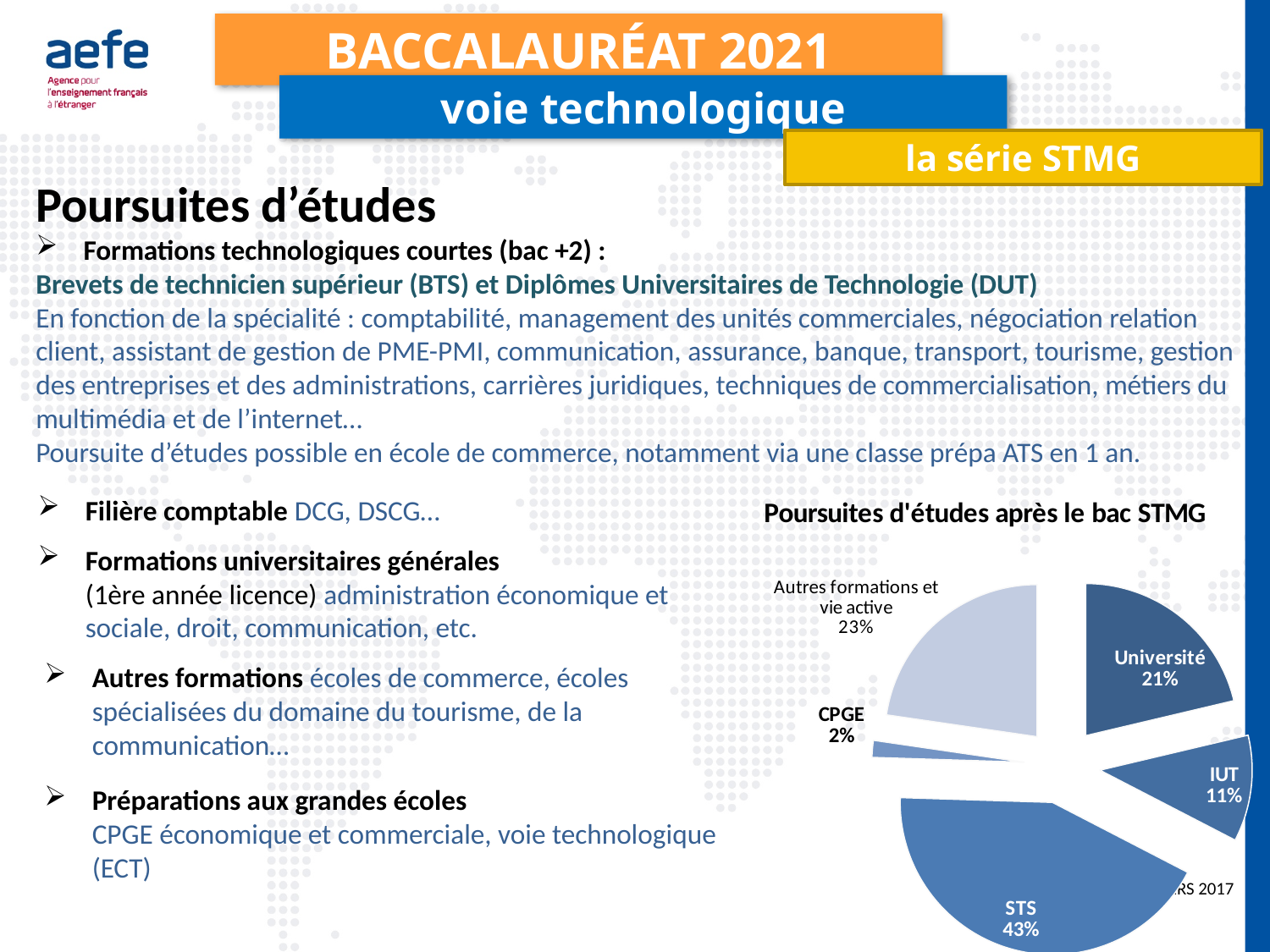
What share of the pie is CPGE? 2% Which slice of the pie is the smallest? CPGE What is the difference between the STS share and the Université share? 22% What share of the pie is STS? 43% What share of the pie is Université? 21% What share of the pie is Autres formations et vie active? 23% Which is larger, the share for IUT or the share for Université? Université What is the title of the chart? Poursuites d'études après le bac STMG How many slices does the pie chart have? 5 Which slice of the pie is the largest? STS What type of chart is shown on the slide? pie chart What share of the pie is IUT? 11%